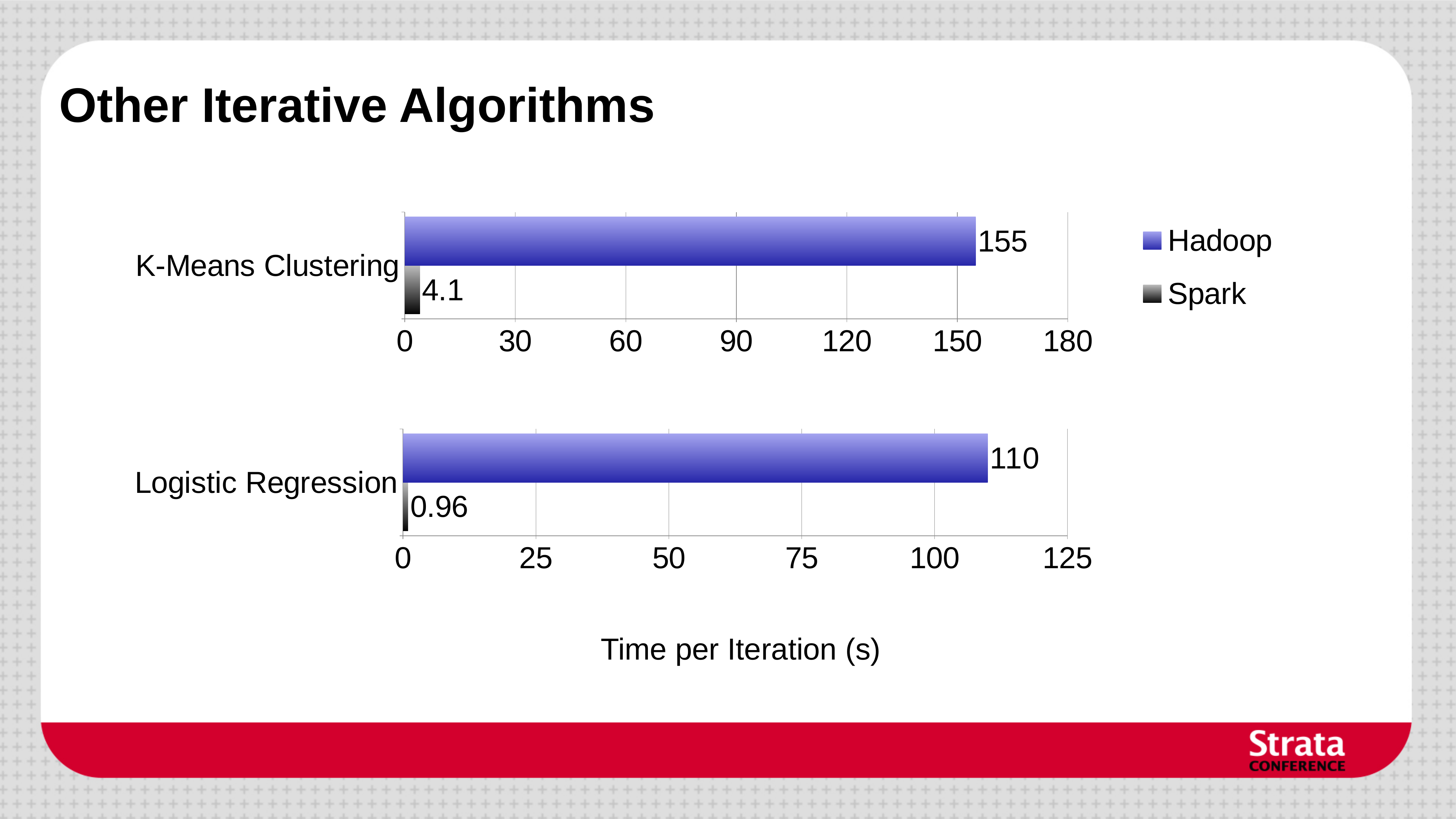
In the bottom chart (Logistic Regression), what is the time per iteration for Spark? 0.96 In the top chart (K-Means Clustering), is the Hadoop value greater or less than 150? greater In the top chart (K-Means Clustering), what is the time per iteration for Hadoop? 155 In the bottom chart (Logistic Regression), which series has the lower time per iteration? Spark In the bottom chart (Logistic Regression), what is the time per iteration for Hadoop? 110 How many series does the legend list? 2 In the top chart (K-Means Clustering), what is the time per iteration for Spark? 4.1 In the top chart (K-Means Clustering), which series has the higher time per iteration, Hadoop or Spark? Hadoop What kind of chart is used on this slide? Bar chart In the bottom chart (Logistic Regression), is the Hadoop value greater or less than 100? greater In the bottom chart (Logistic Regression), what is the difference between the Hadoop and Spark times per iteration? 109.04 In the top chart (K-Means Clustering), what is the difference between the Hadoop and Spark times per iteration? 150.9